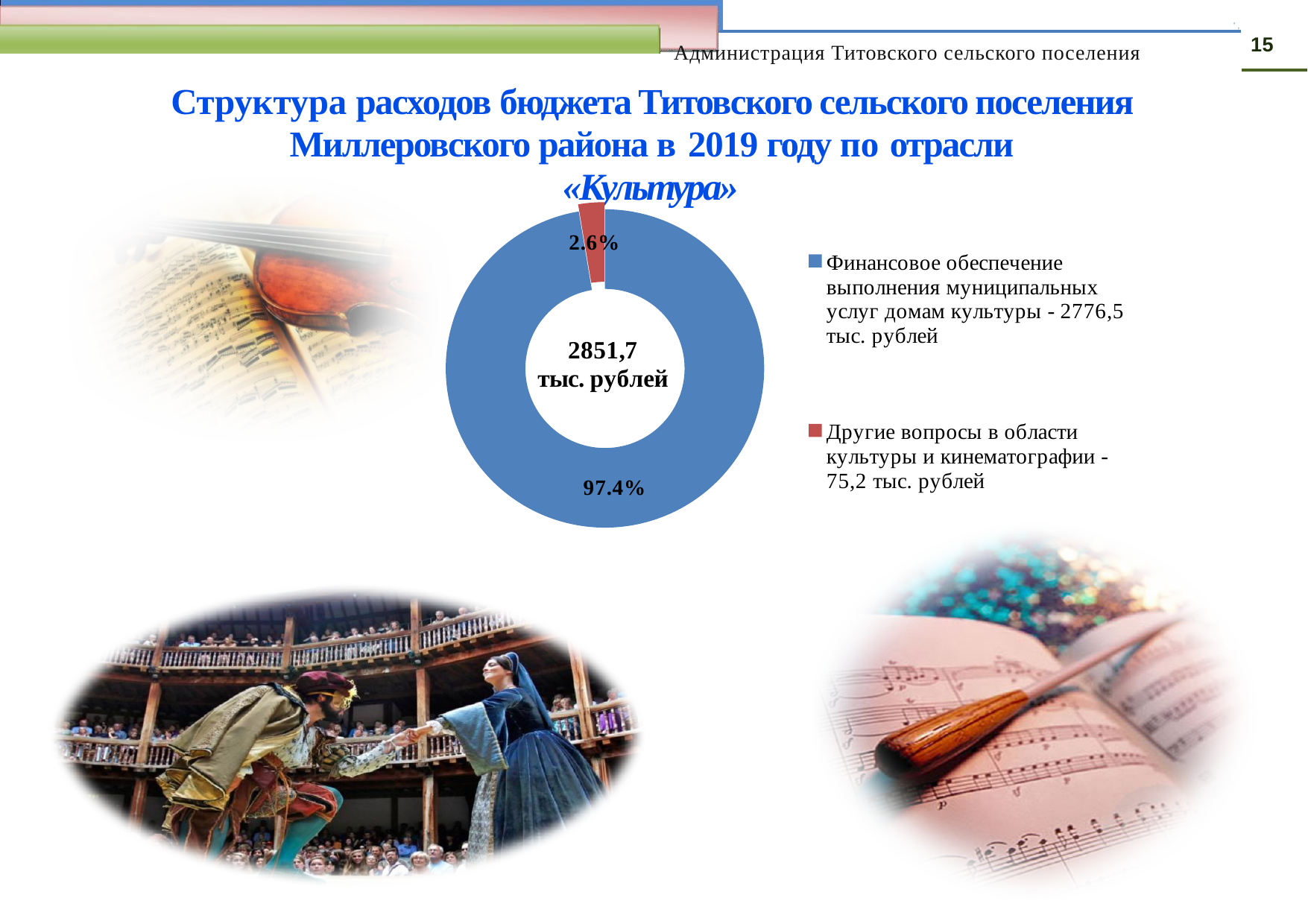
Which is larger: the value for 'Финансовое обеспечение выполнения муниципальных услуг домам культуры' or for 'Другие вопросы в области культуры и кинематографии'? Финансовое обеспечение выполнения муниципальных услуг домам культуры What is the difference in percentage points between the 97.4% slice and the 2.6% slice? 94.8 percentage points Which category has the largest share of the chart? Финансовое обеспечение выполнения муниципальных услуг домам культуры Which category has the smallest share of the chart? Другие вопросы в области культуры и кинематографии What total value is printed in the centre of the doughnut chart? 2851,7 тыс. рублей What share of the chart does the slice for 'Финансовое обеспечение выполнения муниципальных услуг домам культуры' represent? 97.4% What share of the chart does the slice for 'Другие вопросы в области культуры и кинематографии' represent? 2.6% How many categories does the legend list? 2 What kind of chart is shown on the slide? Doughnut (pie) chart What colour is the slice for 'Другие вопросы в области культуры и кинематографии'? Red According to the legend, what is the value for 'Финансовое обеспечение выполнения муниципальных услуг домам культуры'? 2776,5 тыс. рублей According to the legend, what is the value for 'Другие вопросы в области культуры и кинематографии'? 75,2 тыс. рублей